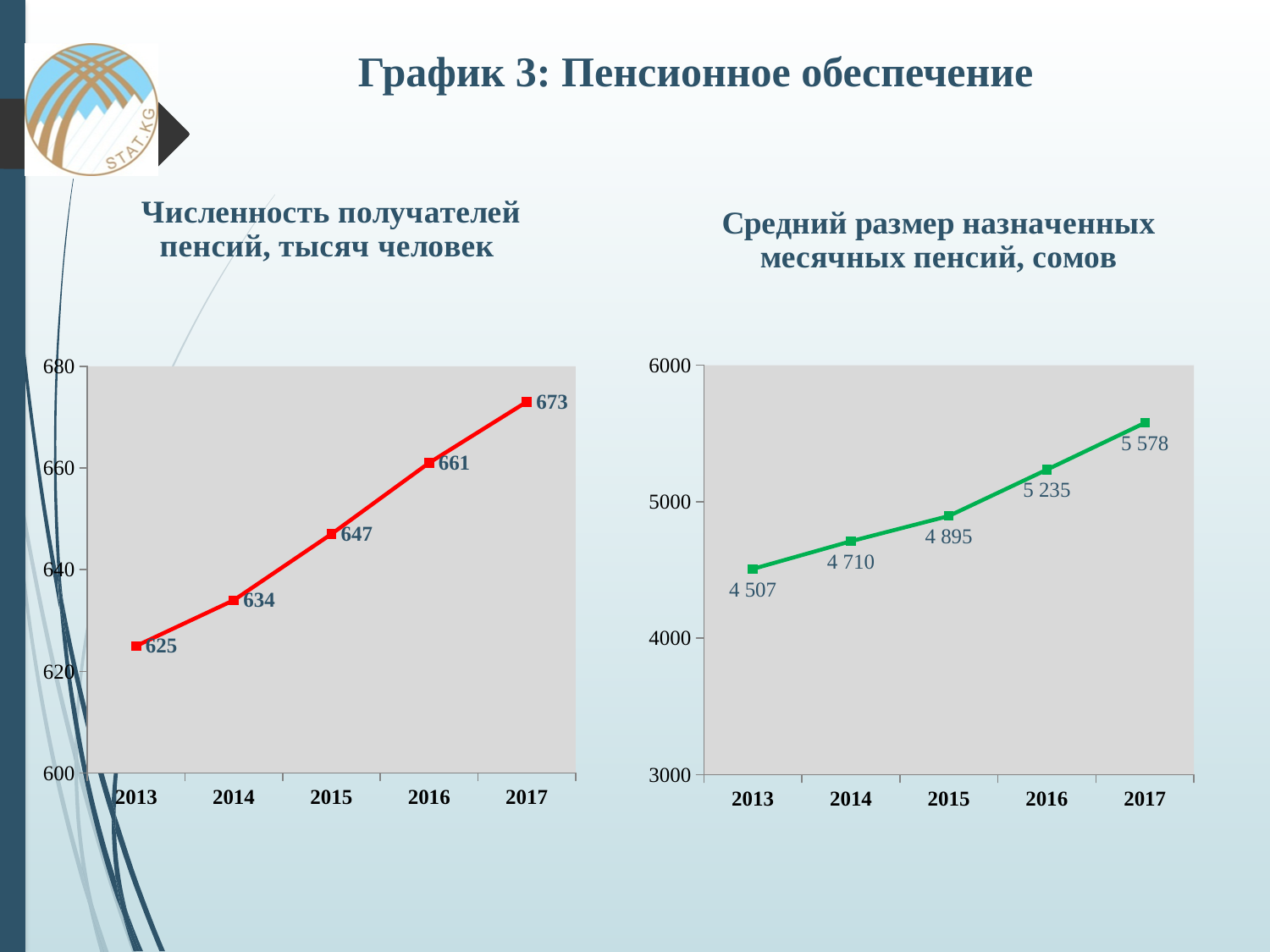
In the left chart (Численность получателей пенсий, тысяч человек), what is the value for 2013? 625 In the left chart (Численность получателей пенсий, тысяч человек), do the values rise or fall from 2013 to 2017? rise In the right chart (Средний размер назначенных месячных пенсий, сомов), what is the difference between the 2017 and 2016 values? 343 In the right chart (Средний размер назначенных месячных пенсий, сомов), what is the value for 2017? 5 578 What kind of chart is the right chart (Средний размер назначенных месячных пенсий, сомов)? line chart In the right chart (Средний размер назначенных месячных пенсий, сомов), what is the value for 2015? 4 895 How many data points are plotted in the left chart (Численность получателей пенсий, тысяч человек)? 5 In the right chart (Средний размер назначенных месячных пенсий, сомов), which year has the highest value? 2017 In the left chart (Численность получателей пенсий, тысяч человек), which year has the lowest value? 2013 In the right chart (Средний размер назначенных месячных пенсий, сомов), is the value for 2016 greater or less than 5000? greater In the left chart (Численность получателей пенсий, тысяч человек), what is the difference between the 2017 and 2013 values? 48 In the left chart (Численность получателей пенсий, тысяч человек), what is the value for 2017? 673